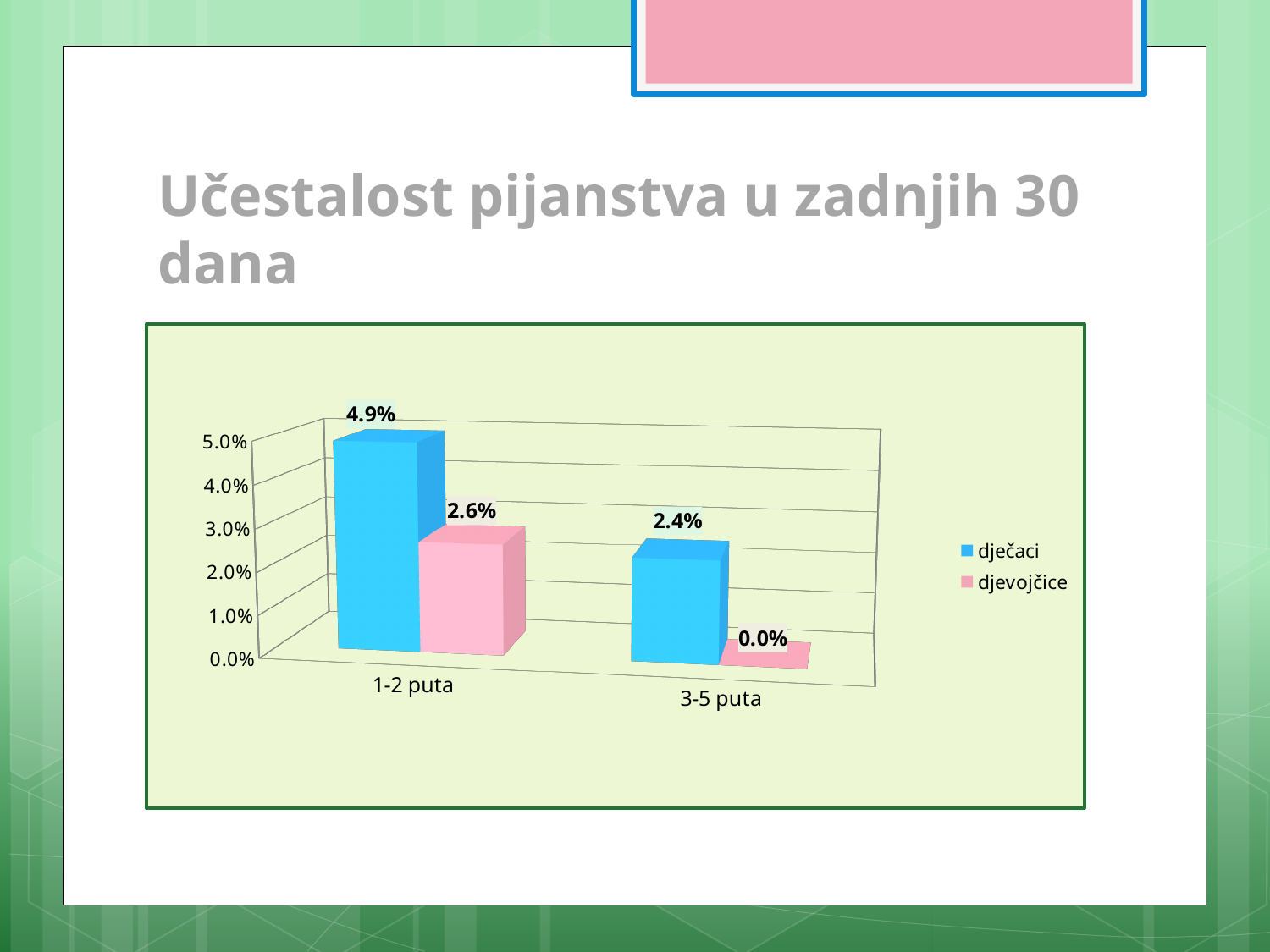
What is the value for dječaci in the 1-2 puta category? 4.9% How many categories are shown on the x axis? 2 What is the value for dječaci in the 3-5 puta category? 2.4% What is the value for djevojčice in the 3-5 puta category? 0.0% Which category has the lowest value for djevojčice? 3-5 puta How many series does the legend list? 2 What is the title of the slide? Učestalost pijanstva u zadnjih 30 dana What kind of chart is shown on the slide? bar chart What is the value for djevojčice in the 1-2 puta category? 2.6% Which category has the highest value for dječaci? 1-2 puta What is the difference between the dječaci and djevojčice values in the 1-2 puta category? 2.3% Which is larger in the 3-5 puta category, dječaci or djevojčice? dječaci